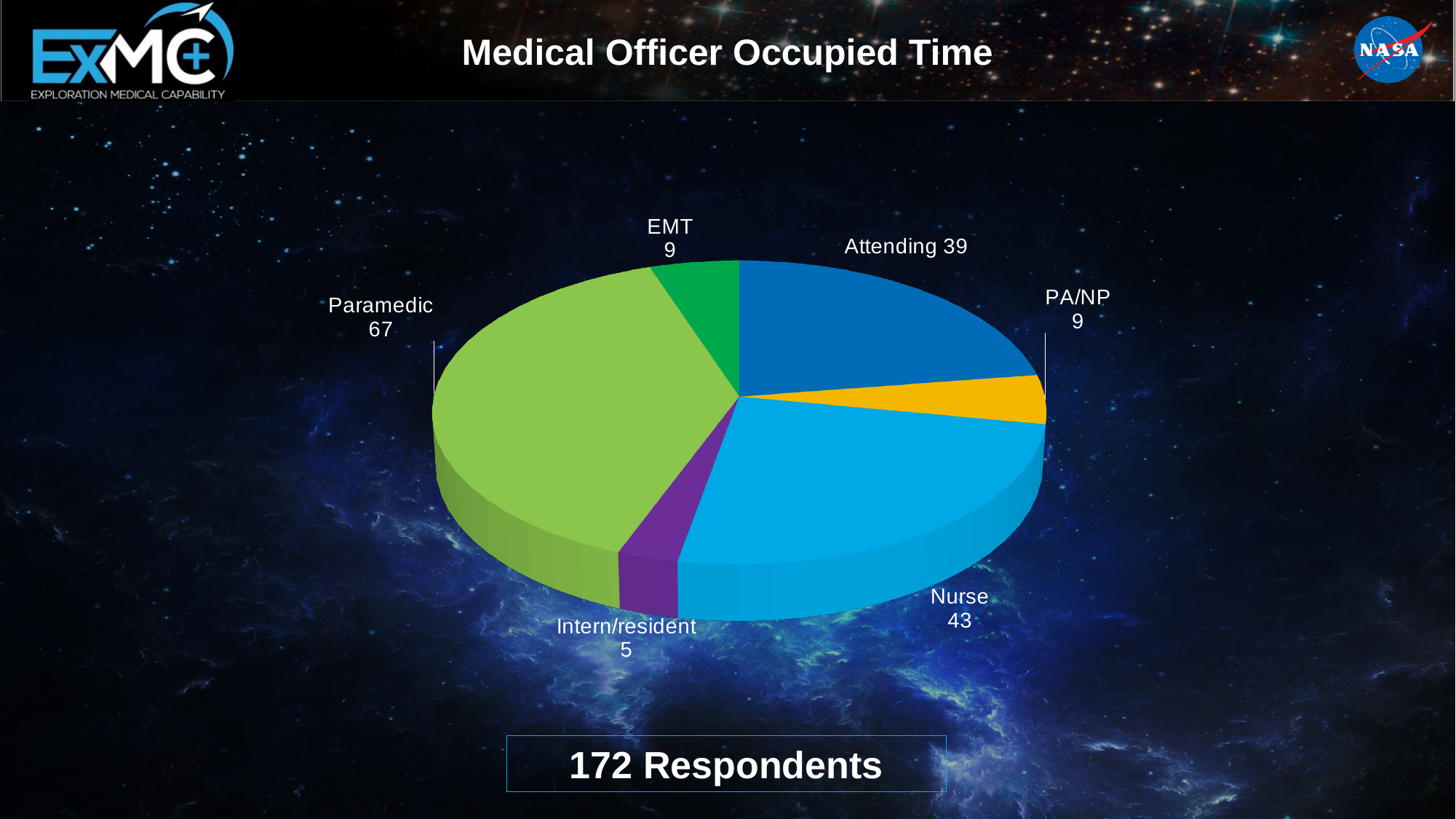
What type of chart is shown on the slide? Pie chart Which category has the smallest slice of the pie chart? Intern/resident What is the value for Paramedic in the pie chart? 67 What is the value for Intern/resident in the pie chart? 5 Which category has the largest slice of the pie chart? Paramedic Which is larger, the value for Attending or the value for Nurse? Nurse How many categories are shown in the pie chart? 6 What is the value for Nurse in the pie chart? 43 How many respondents does the slide report in total? 172 What is the value for Attending in the pie chart? 39 What is the difference between the Paramedic and Nurse values? 24 What is the title of the slide containing the pie chart? Medical Officer Occupied Time